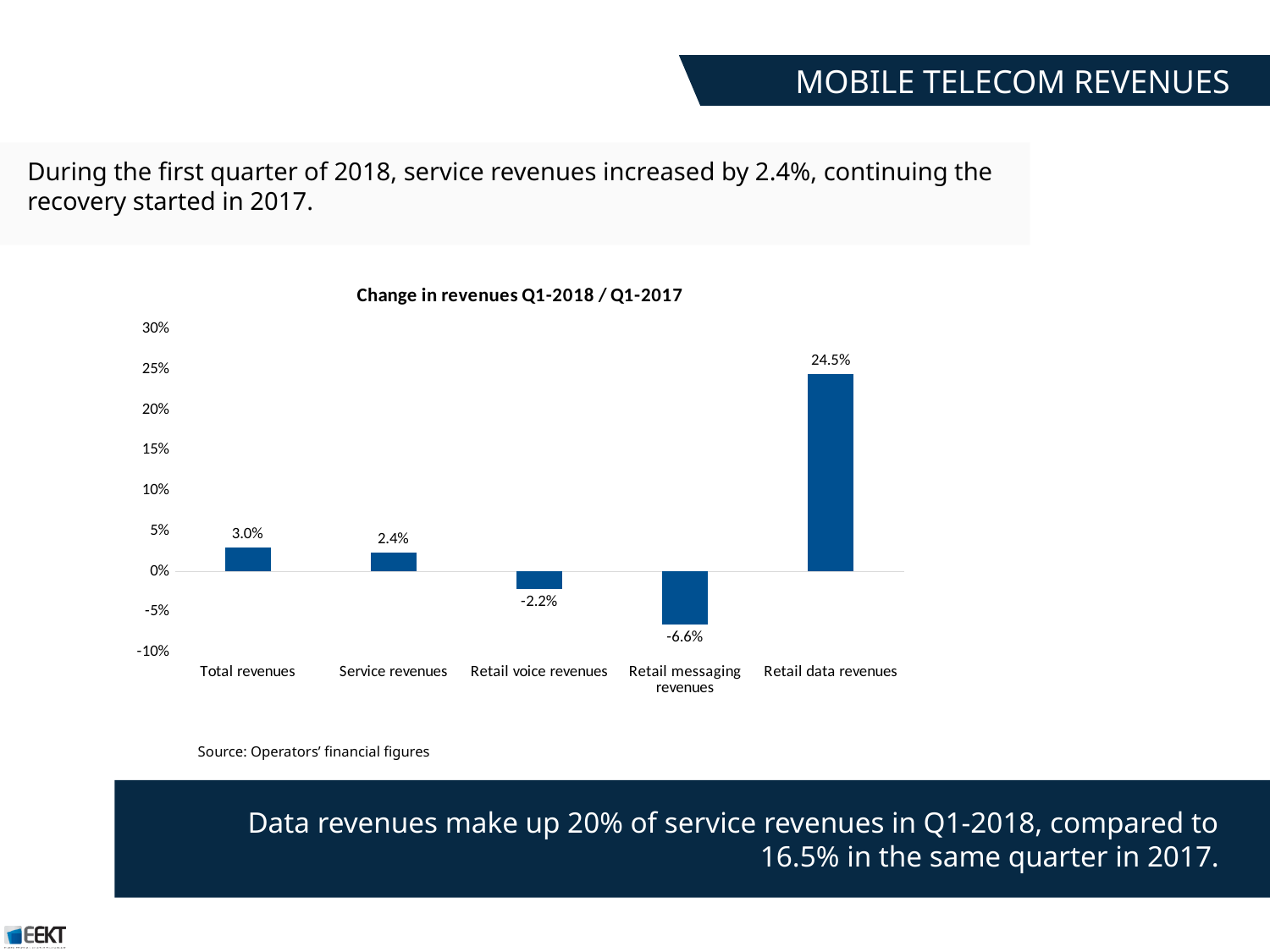
What is the source given below the chart? Operators' financial figures What is the title of the chart? Change in revenues Q1-2018 / Q1-2017 What is the change in Retail messaging revenues shown in the chart? -6.6% What is the difference between the change for Total revenues and the change for Service revenues? 0.6 percentage points What kind of chart is shown on the slide? Bar chart Which category has the highest change in revenues? Retail data revenues Which category has the lowest change in revenues? Retail messaging revenues What is the change in Retail data revenues shown in the chart? 24.5% What is the change in Total revenues shown in the chart? 3.0% How many categories are shown in the chart? 5 Is the value for Retail data revenues greater or less than 20%? greater Which is larger, the change for Retail voice revenues or the change for Retail messaging revenues? Retail voice revenues